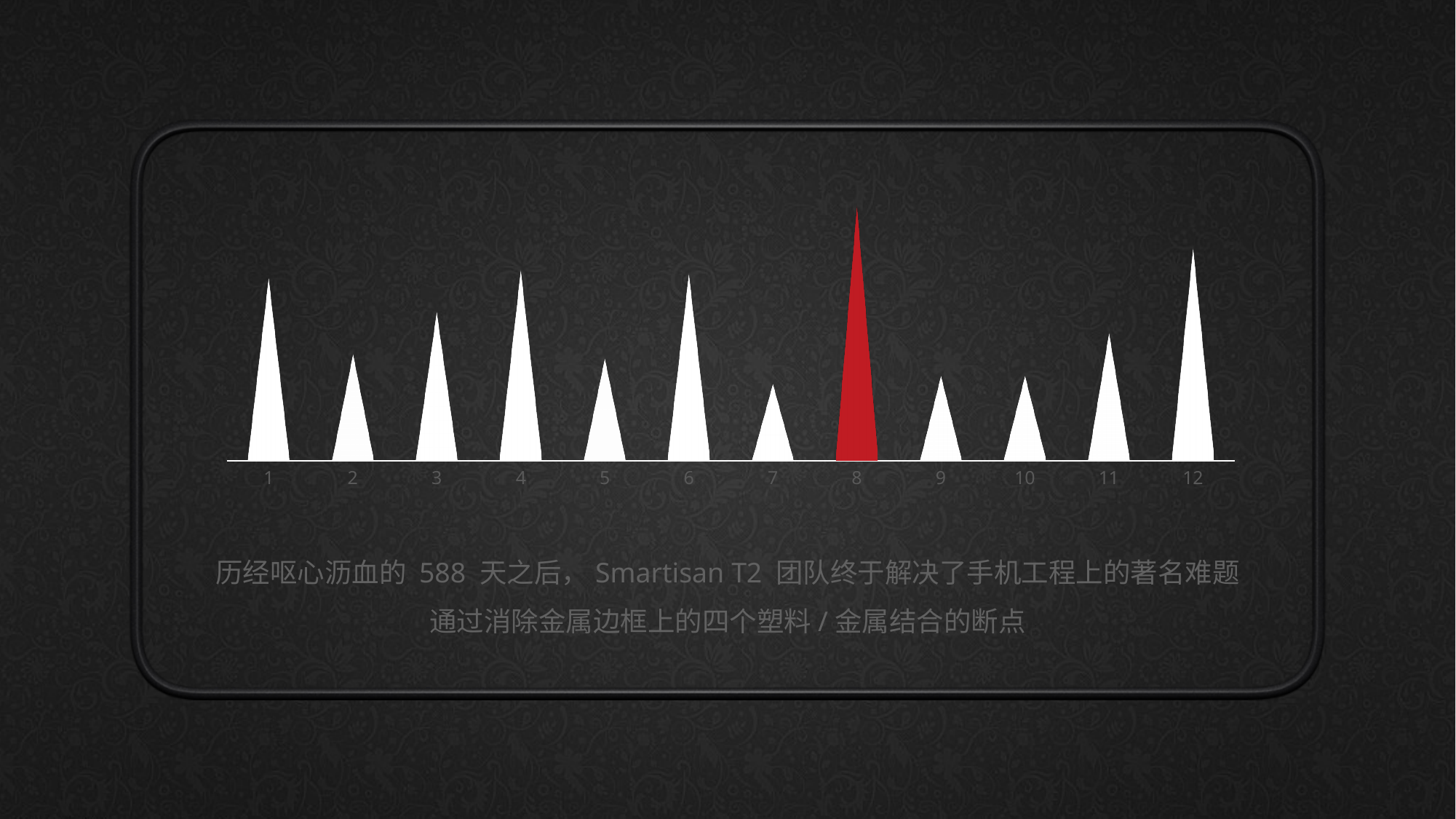
Which category is drawn in red on the chart? 8 What kind of chart is shown on the slide? bar chart Which is larger on the chart, the value for category 4 or category 5? 4 What colour are the bars on the chart other than the one for category 8? white How many categories are shown on the chart's x axis? 12 Which is larger on the chart, the value for category 8 or category 9? 8 Which is larger on the chart, the value for category 1 or category 2? 1 Which category has the highest value on the chart? 8